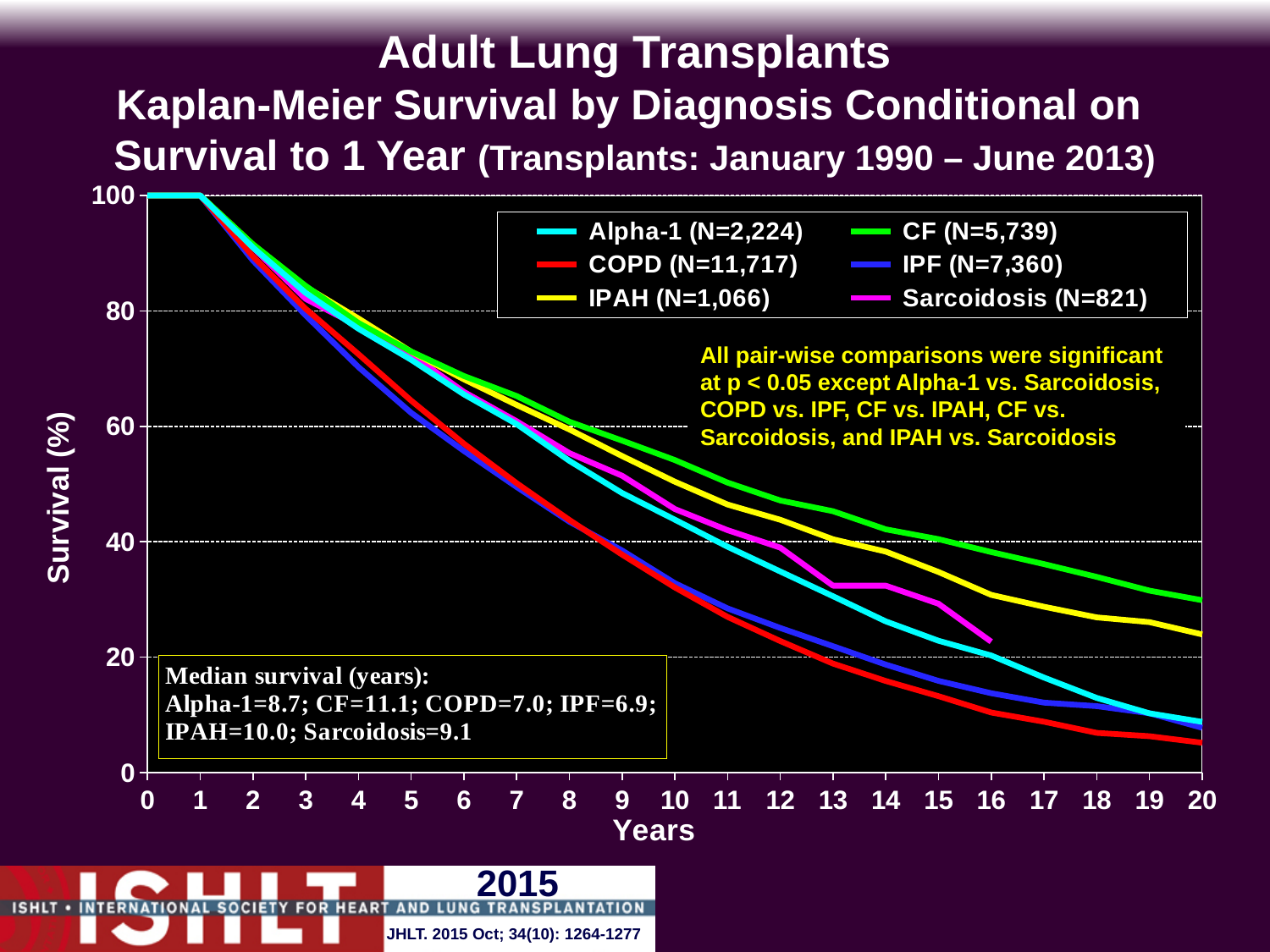
What is the median survival in years for CF according to the text box? 11.1 Which diagnosis has the lowest median survival listed in the text box? IPF What kind of chart is shown on the slide? line chart How many diagnosis groups does the legend list? 6 Which diagnosis curve shows the highest survival at 20 years? CF What is the difference in median survival (years) between CF and COPD? 4.1 Is the survival value for CF at 20 years greater or less than 20? greater How many patients (N) are in the COPD group according to the legend? 11,717 Which diagnosis has the highest median survival listed in the text box? CF What is the median survival in years for IPF according to the text box? 6.9 Which diagnosis curve shows the lowest survival at 20 years? COPD Is the survival value for IPF at 10 years greater or less than 40? less